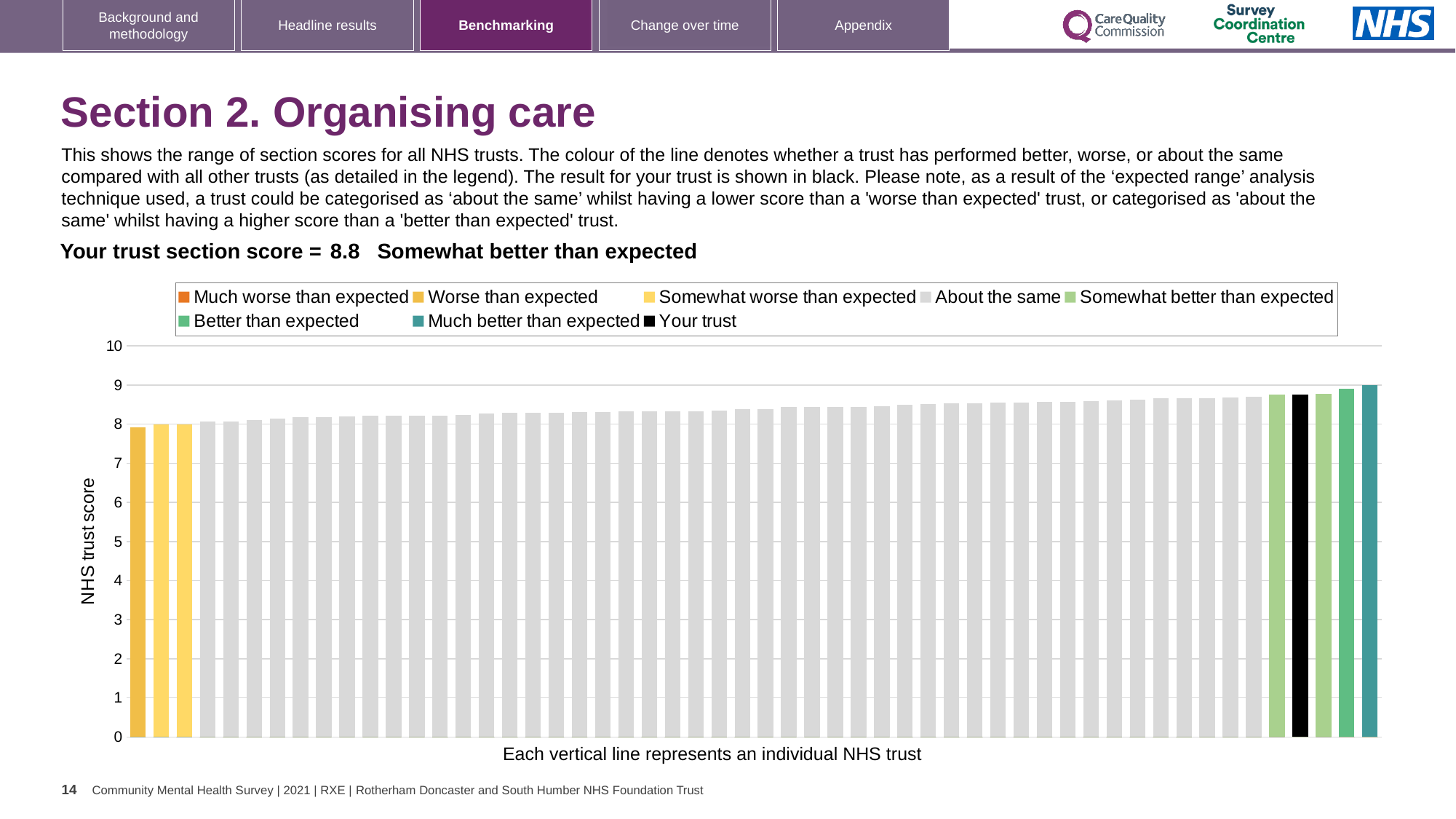
Which category does the slide assign to your trust's section score? Somewhat better than expected How many bars at the left of the chart are coloured yellow rather than grey? 3 What is the title of the vertical axis? NHS trust score What is the section score for your trust shown on the slide? 8.8 Is the value of the black bar (your trust) greater or less than 8? greater Which bar is higher: the black bar for your trust or the leftmost bar? the black bar for your trust How many entries does the chart legend list? 8 What kind of chart is shown on the slide? bar chart Do the bar values rise or fall from left to right across the chart? rise Is the value of the leftmost bar greater or less than 9? less What colour is the bar representing your trust? black Is the value of the rightmost bar greater or less than 8? greater